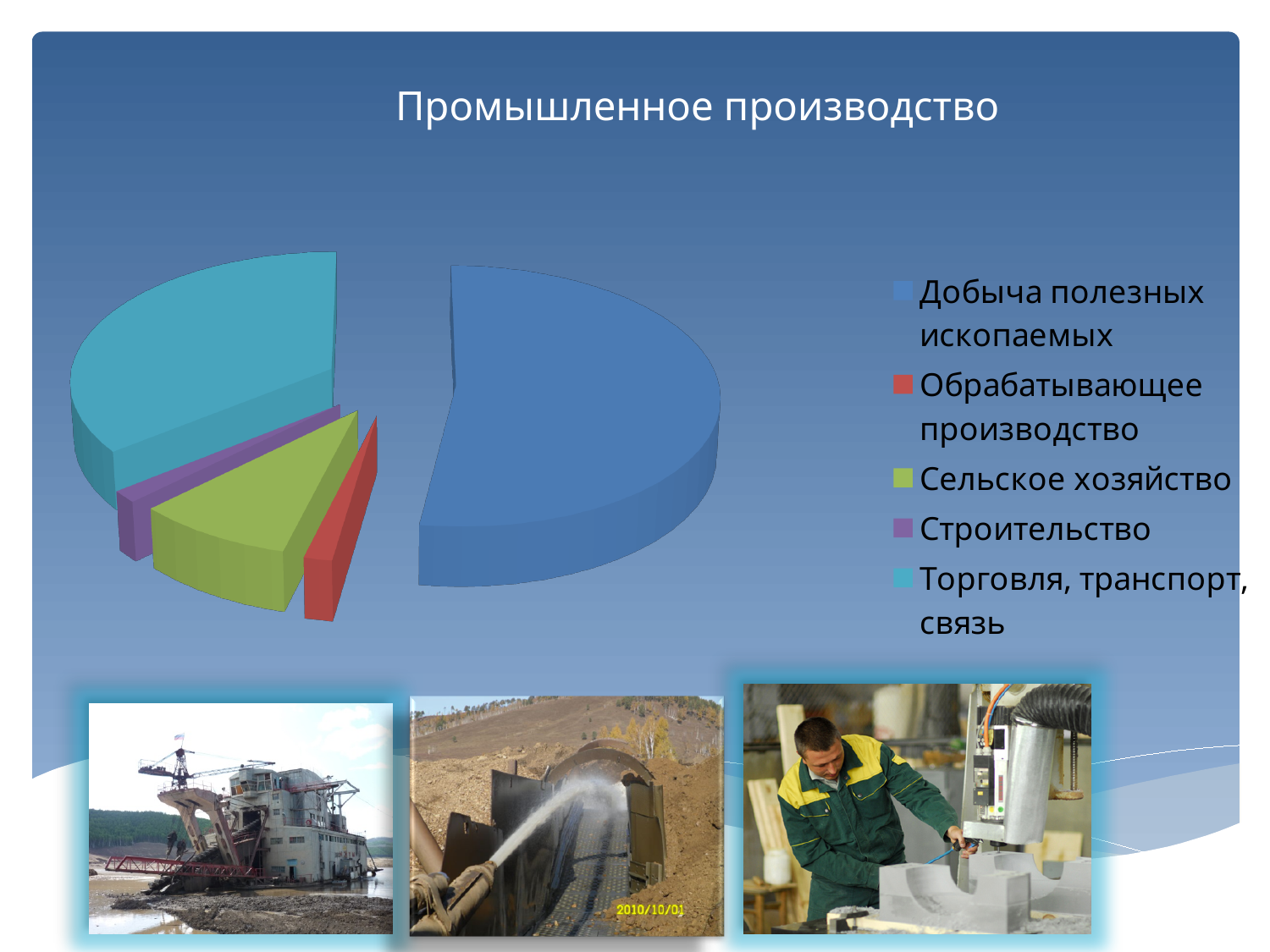
Which category is shown in green in the pie chart? Сельское хозяйство Which category has the largest slice of the pie? Добыча полезных ископаемых What kind of chart is shown on the slide? pie chart Which slice is larger: Добыча полезных ископаемых or Торговля, транспорт, связь? Добыча полезных ископаемых Which slice is larger: Сельское хозяйство or Строительство? Сельское хозяйство Which slice is larger: Добыча полезных ископаемых or Сельское хозяйство? Добыча полезных ископаемых What is the title of the chart? Промышленное производство How many categories does the pie chart have? 5